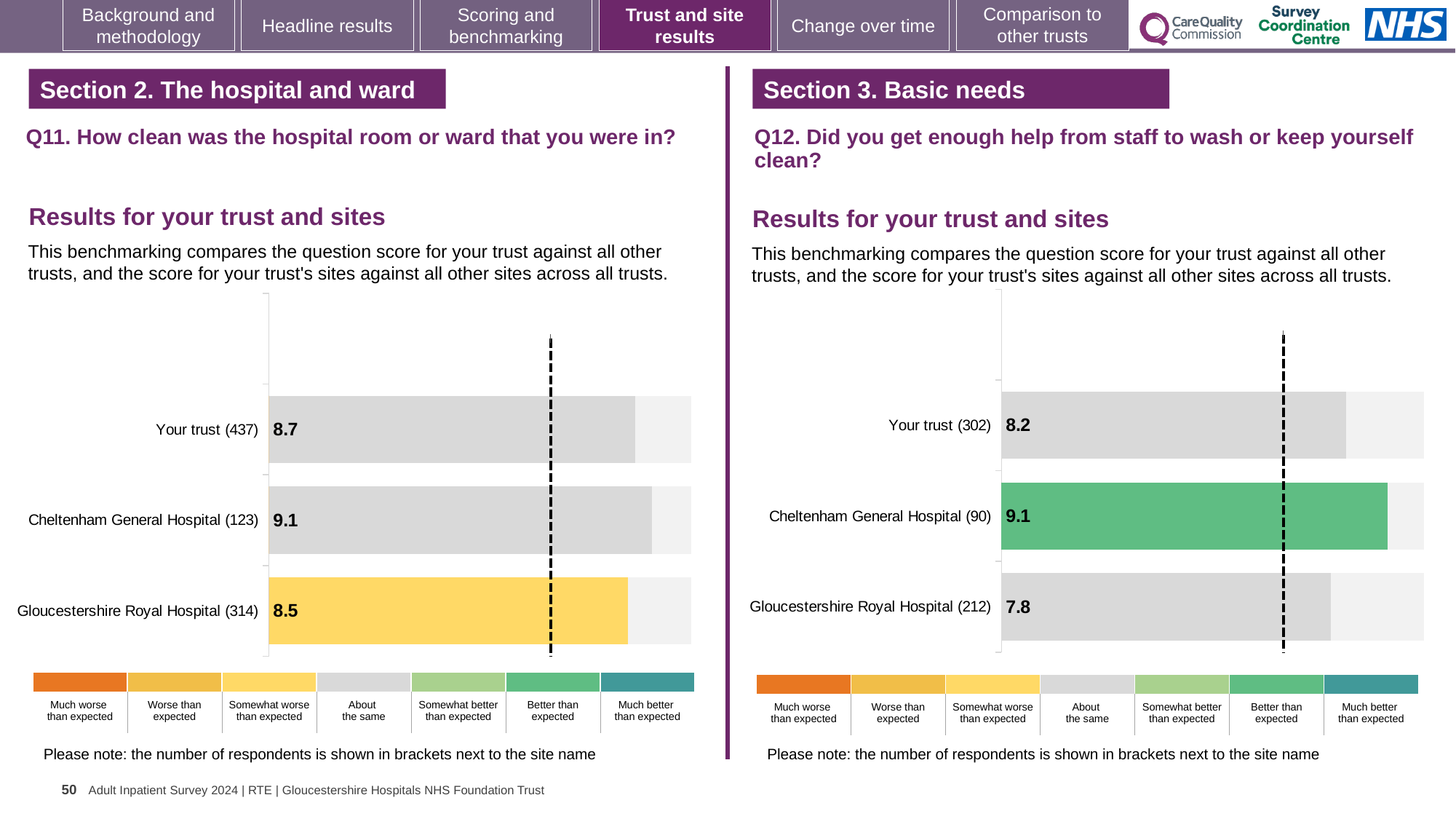
In the Q11 chart on the left, what is the difference between the scores for Cheltenham General Hospital and Gloucestershire Royal Hospital? 0.6 What kind of chart is used for the Q12 results on the right? Bar chart In the Q12 chart on the right, which has the larger score, Your trust or Gloucestershire Royal Hospital? Your trust In the Q12 chart on the right, what is the score for Gloucestershire Royal Hospital? 7.8 How many bars are plotted in the Q11 chart on the left? 3 In the Q12 chart on the right, what is the difference between the scores for Cheltenham General Hospital and Gloucestershire Royal Hospital? 1.3 In the Q11 chart on the left, what is the score for Cheltenham General Hospital? 9.1 In the Q12 chart on the right, which site or trust has the lowest score? Gloucestershire Royal Hospital In the Q11 chart on the left, how many respondents are shown in brackets for Your trust? 437 In the Q11 chart on the left, which site or trust has the highest score? Cheltenham General Hospital In the Q12 chart on the right, what is the score for Your trust? 8.2 In the Q11 chart on the left, what is the score for Gloucestershire Royal Hospital? 8.5